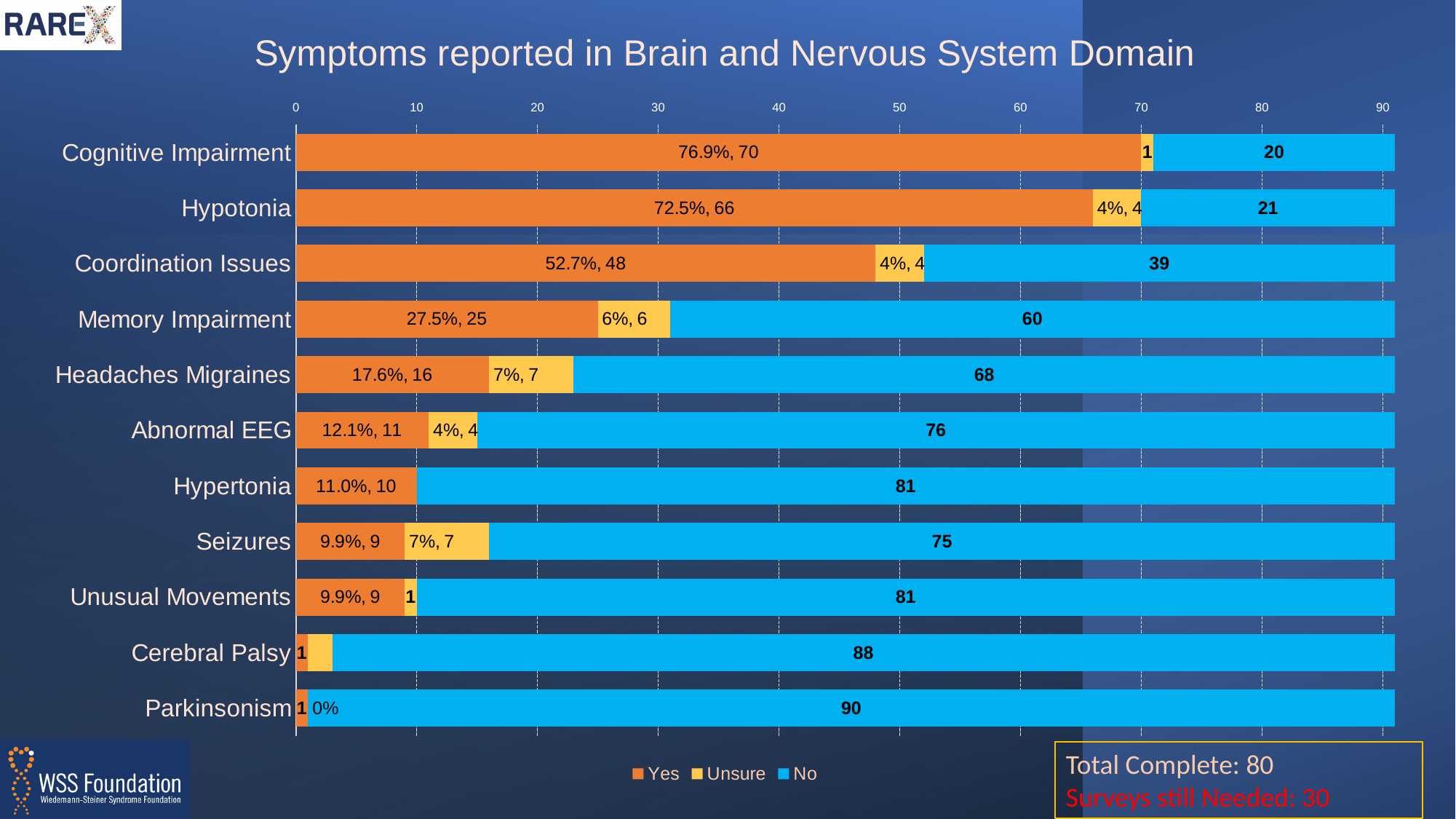
Which symptom has the highest 'No' count? Parkinsonism What is the difference between the 'No' counts for Abnormal EEG and Memory Impairment? 16 What type of chart is shown on the slide? stacked bar chart What is the title of the chart? Symptoms reported in Brain and Nervous System Domain What is the 'No' value for Coordination Issues? 39 What is the 'Yes' value for Hypotonia? 72.5%, 66 Which is larger, the 'Yes' count for Coordination Issues or the 'No' count for Coordination Issues? Yes count for Coordination Issues What is the 'Unsure' value for Headaches Migraines? 7%, 7 How many symptom categories are plotted in the chart? 11 Which symptom has the highest 'Yes' count? Cognitive Impairment What is the total of the stacked bar for Memory Impairment? 91 How many series does the legend list? 3